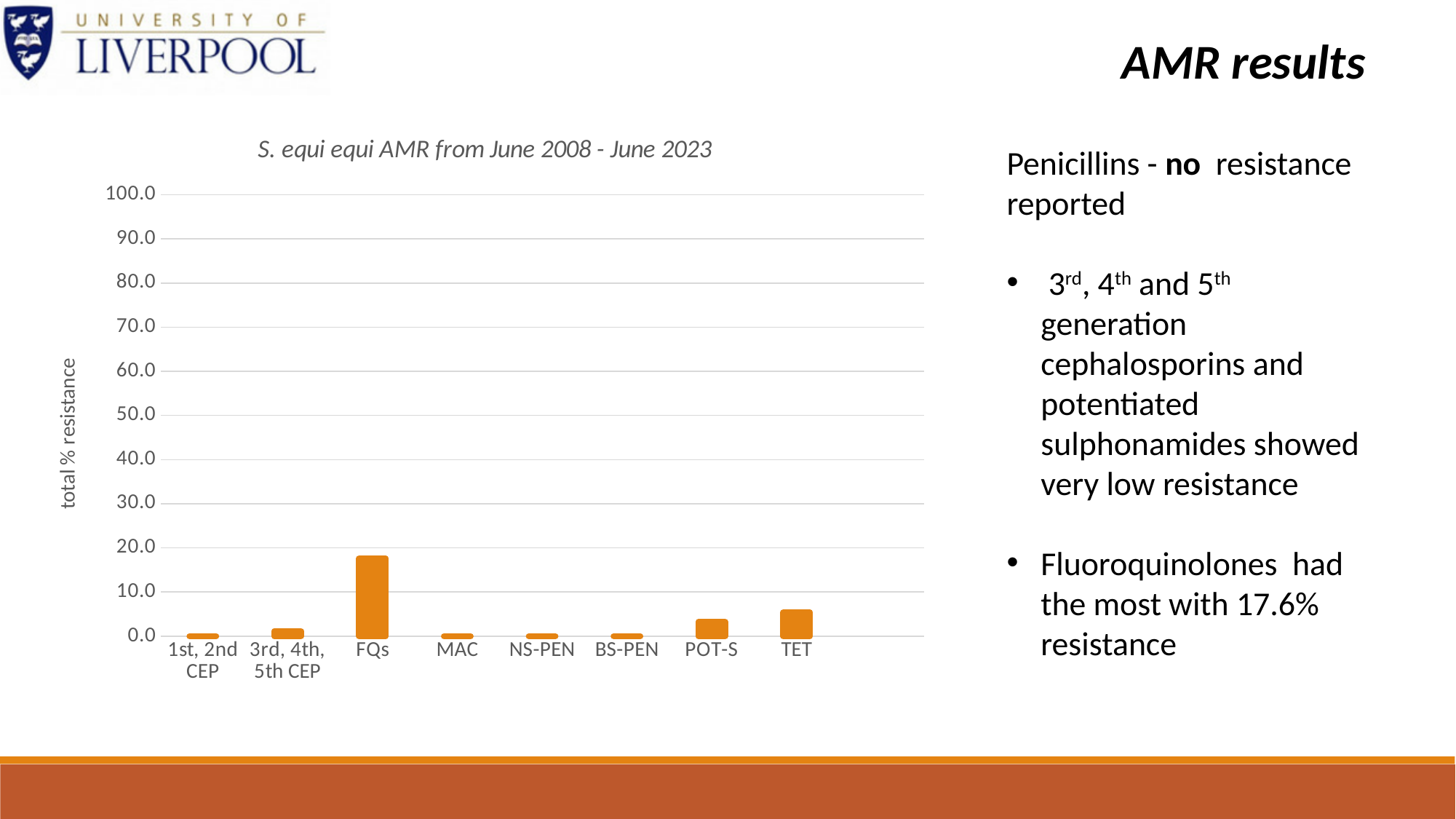
What kind of chart is shown on the slide? bar chart Is the value for POT-S greater or less than 10.0? less What is the highest value shown on the vertical axis of the chart? 100.0 Is the value for FQs greater or less than 20.0? less How many antimicrobial categories are shown on the x axis of the chart? 8 Is the value for FQs greater or less than 10.0? greater What is the label on the vertical axis of the chart? total % resistance Which has a higher total % resistance, TET or POT-S? TET What is the title of the chart? S. equi equi AMR from June 2008 - June 2023 Which category has the highest total % resistance in the chart? FQs Which has a higher total % resistance, FQs or TET? FQs